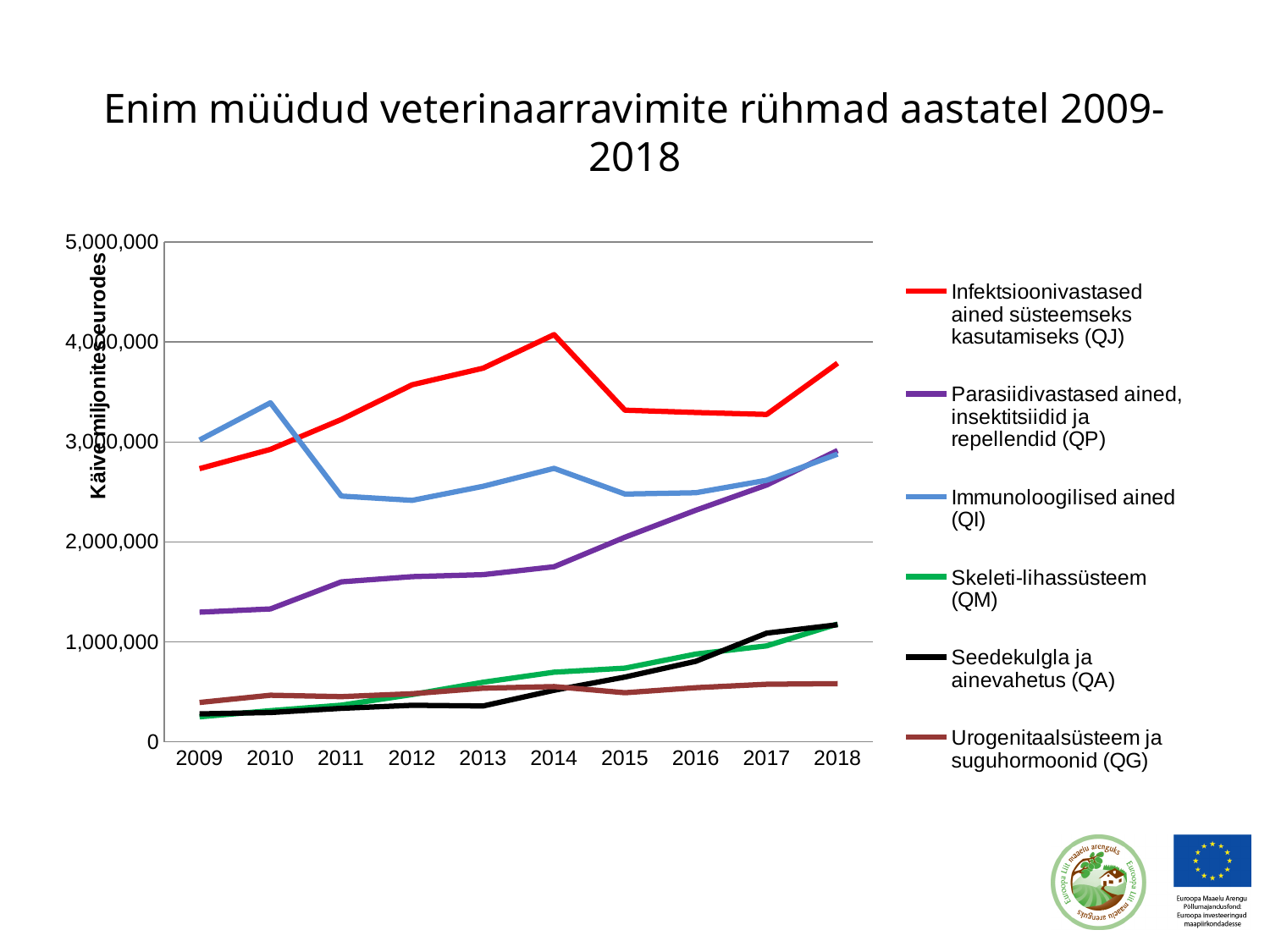
Is the value for Seedekulgla ja ainevahetus (QA) in 2018 greater or less than 1,000,000? greater Does the Parasiidivastased ained, insektitsiidid ja repellendid (QP) series generally rise or fall from 2009 to 2018? rise How many series does the legend list? 6 Is the value for Urogenitaalsüsteem ja suguhormoonid (QG) in 2018 greater or less than 1,000,000? less In which year does the Infektsioonivastased ained süsteemseks kasutamiseks (QJ) series reach its highest value? 2014 How many years are shown along the x axis? 10 What kind of chart is shown on the slide? line chart What is the label on the y axis of the chart? Käive miljonites eurodes Which series has the highest value in 2018? Infektsioonivastased ained süsteemseks kasutamiseks (QJ) In 2009, which is larger: Immunoloogilised ained (QI) or Infektsioonivastased ained süsteemseks kasutamiseks (QJ)? Immunoloogilised ained (QI) Is the value for Immunoloogilised ained (QI) in 2010 greater or less than 3,000,000? greater